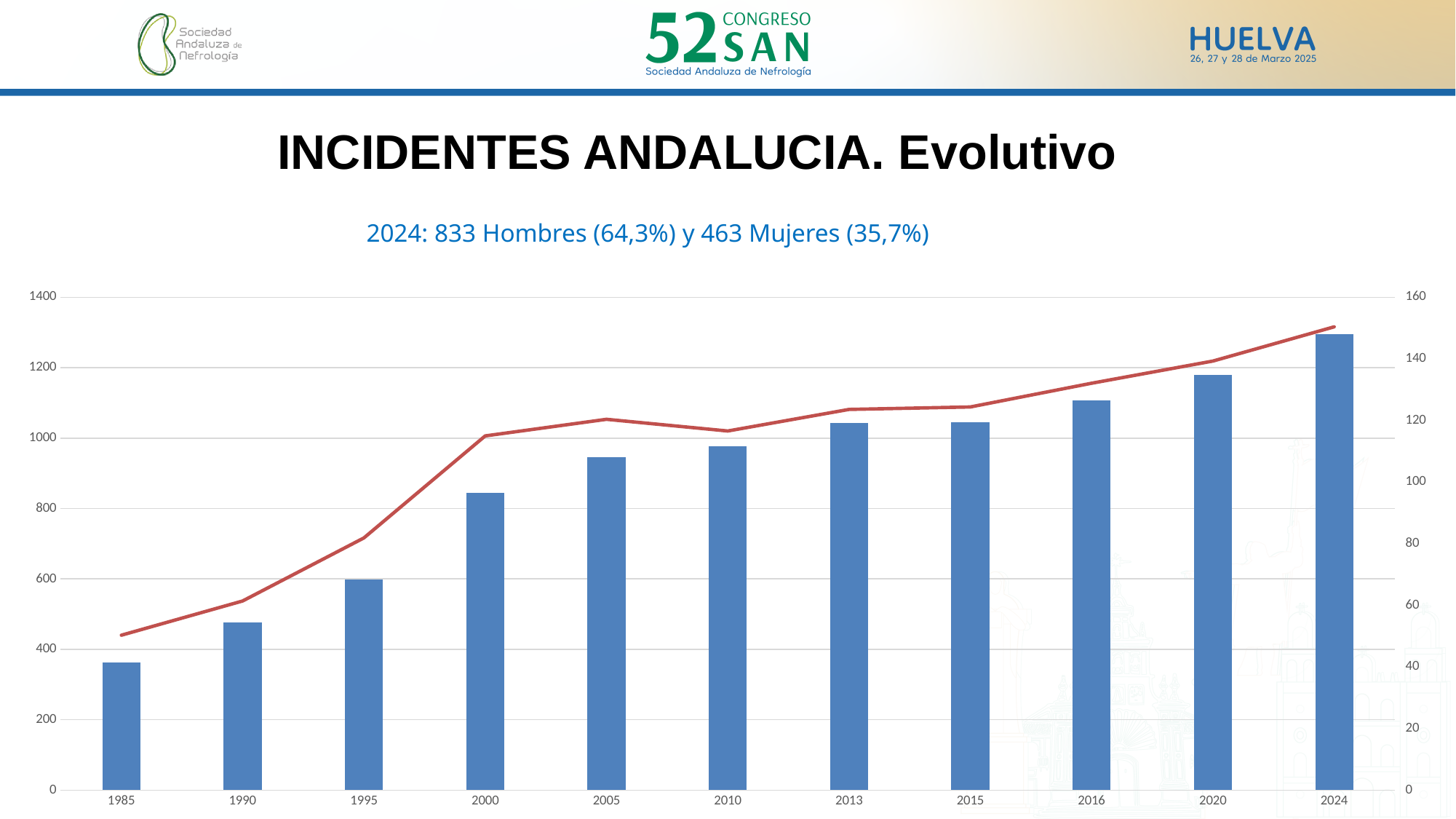
Is the bar value for 2005 greater or less than 1000 on the left axis? less Is the bar value for 2000 greater or less than 800 on the left axis? greater What kind of chart is shown on the slide? A bar chart with a line overlaid Is the bar value for 1985 greater or less than 400 on the left axis? less What is the highest tick value shown on the right-hand axis? 160 Which year has the shortest bar? 1985 How many years are shown on the x axis of the chart? 11 Which year has the taller bar, 2016 or 2020? 2020 Do the bar values generally rise or fall from 1985 to 2024? rise Which year has the tallest bar? 2024